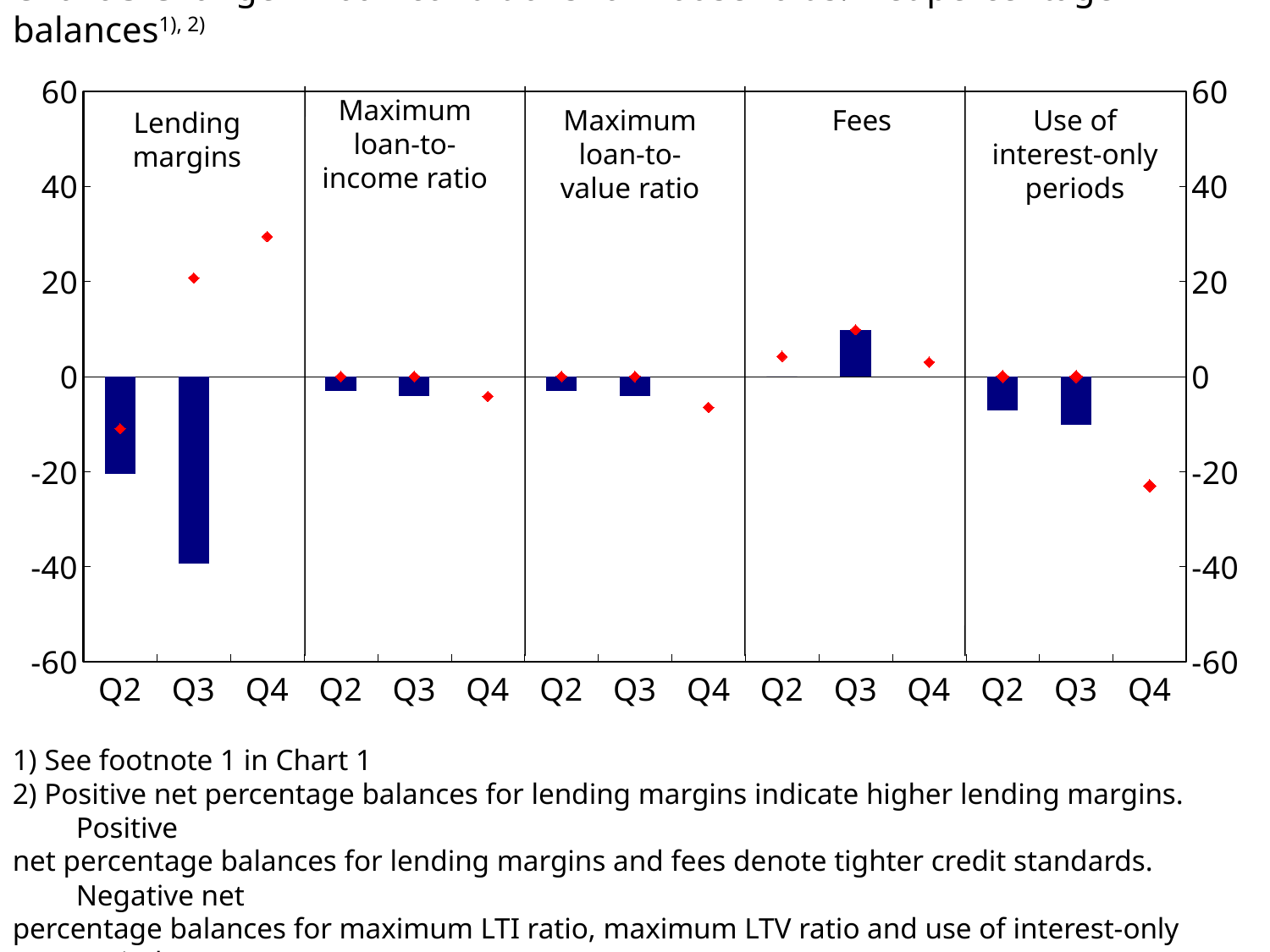
How many panels (credit standard categories) does the chart have? 5 Which panel contains the highest bar in the chart? Fees In the Lending margins panel, is the value of the Q3 bar greater or less than -20? less In the Fees panel, is the value of the Q3 bar greater or less than 20? less How many quarters are shown in each panel of the chart? 3 In the Lending margins panel, is the value of the Q4 red marker greater or less than 20? greater In the Lending margins panel, do the red markers rise or fall from Q2 to Q4? rise Which panel contains the lowest bar in the chart? Lending margins In the Lending margins panel, which bar is lower, Q2 or Q3? Q3 What kind of chart is shown on the slide? combination bar and line chart (bars with red diamond markers)